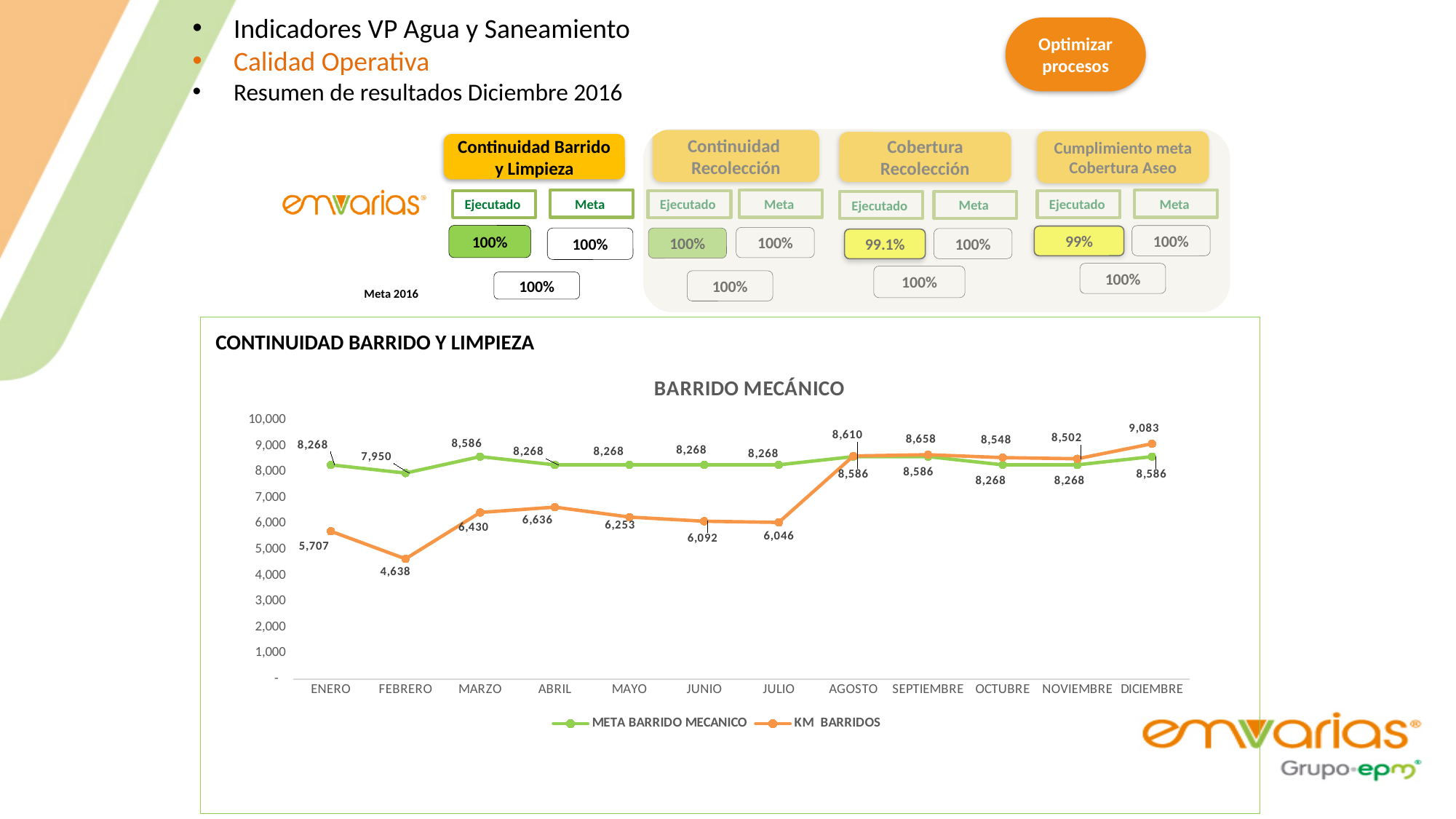
In which month is KM BARRIDOS lowest? FEBRERO What is the value of KM BARRIDOS in FEBRERO? 4,638 What is the difference between META BARRIDO MECANICO and KM BARRIDOS in FEBRERO? 3,312 How many series does the chart legend list? 2 In ENERO, which series has the larger value, META BARRIDO MECANICO or KM BARRIDOS? META BARRIDO MECANICO What is the value of META BARRIDO MECANICO in MARZO? 8,586 What is the difference between KM BARRIDOS and META BARRIDO MECANICO in DICIEMBRE? 497 In which month is KM BARRIDOS highest? DICIEMBRE What type of chart is shown on the slide? Line chart What is the value of KM BARRIDOS in AGOSTO? 8,610 In which month is META BARRIDO MECANICO lowest? FEBRERO How many months are shown on the x axis of the chart? 12